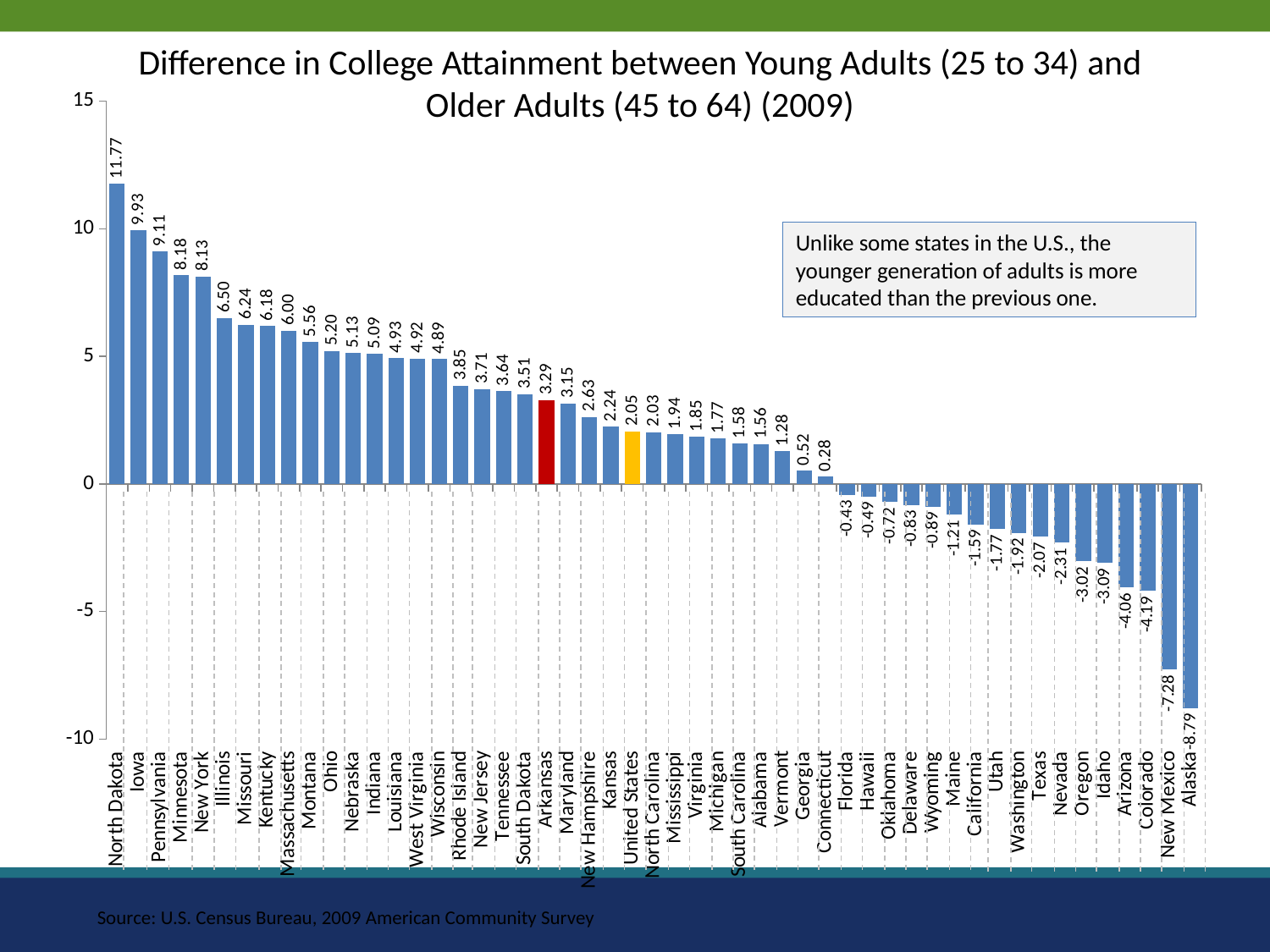
Which category has the lowest value? Alaska What is the value for Alaska? -8.79 What kind of chart is shown on the slide? Bar chart Do the values rise or fall moving from left to right along the x axis? Fall What is the value for New Mexico? -7.28 What is the value for Arkansas? 3.29 Which has a larger value, Iowa or Pennsylvania? Iowa What is the value for United States? 2.05 Which bar is coloured red? Arkansas What is the value for North Dakota? 11.77 What is the difference between the values for Arkansas and United States? 1.24 Which category has the highest value? North Dakota